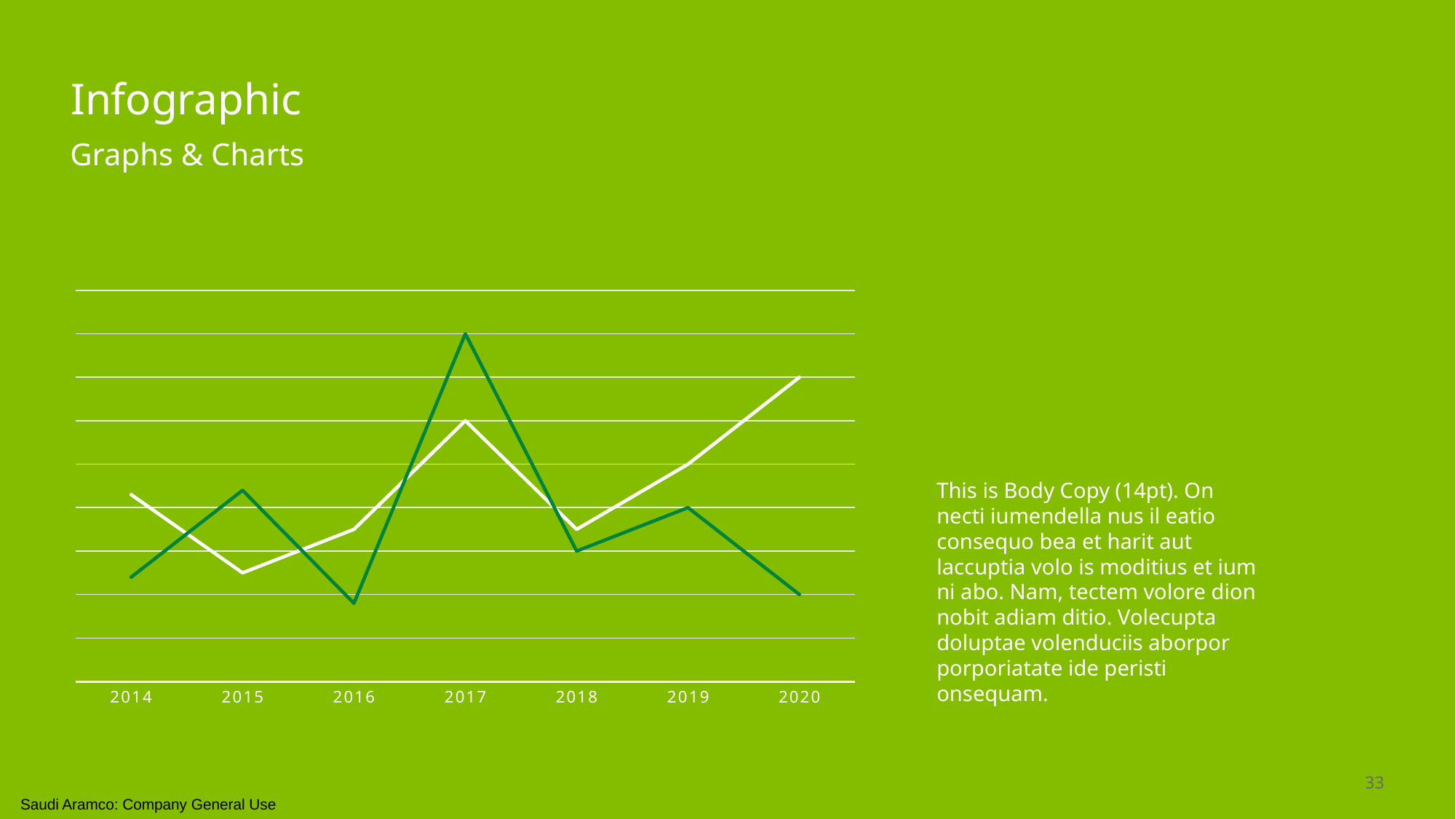
In 2020, which line is higher, the white line or the dark green line? the white line Does the white line rise or fall from 2018 to 2020? rise How many lines are plotted on the chart? 2 What kind of chart is shown on the slide? line chart In 2017, which line is higher, the white line or the dark green line? the dark green line What is the first year shown on the x axis of the chart? 2014 In which year does the white line reach its lowest point? 2015 How many years are shown on the x axis of the chart? 7 Does the dark green line rise or fall from 2017 to 2018? fall In which year does the dark green line reach its highest point? 2017 What is the last year shown on the x axis of the chart? 2020 In which year does the white line reach its highest point? 2020